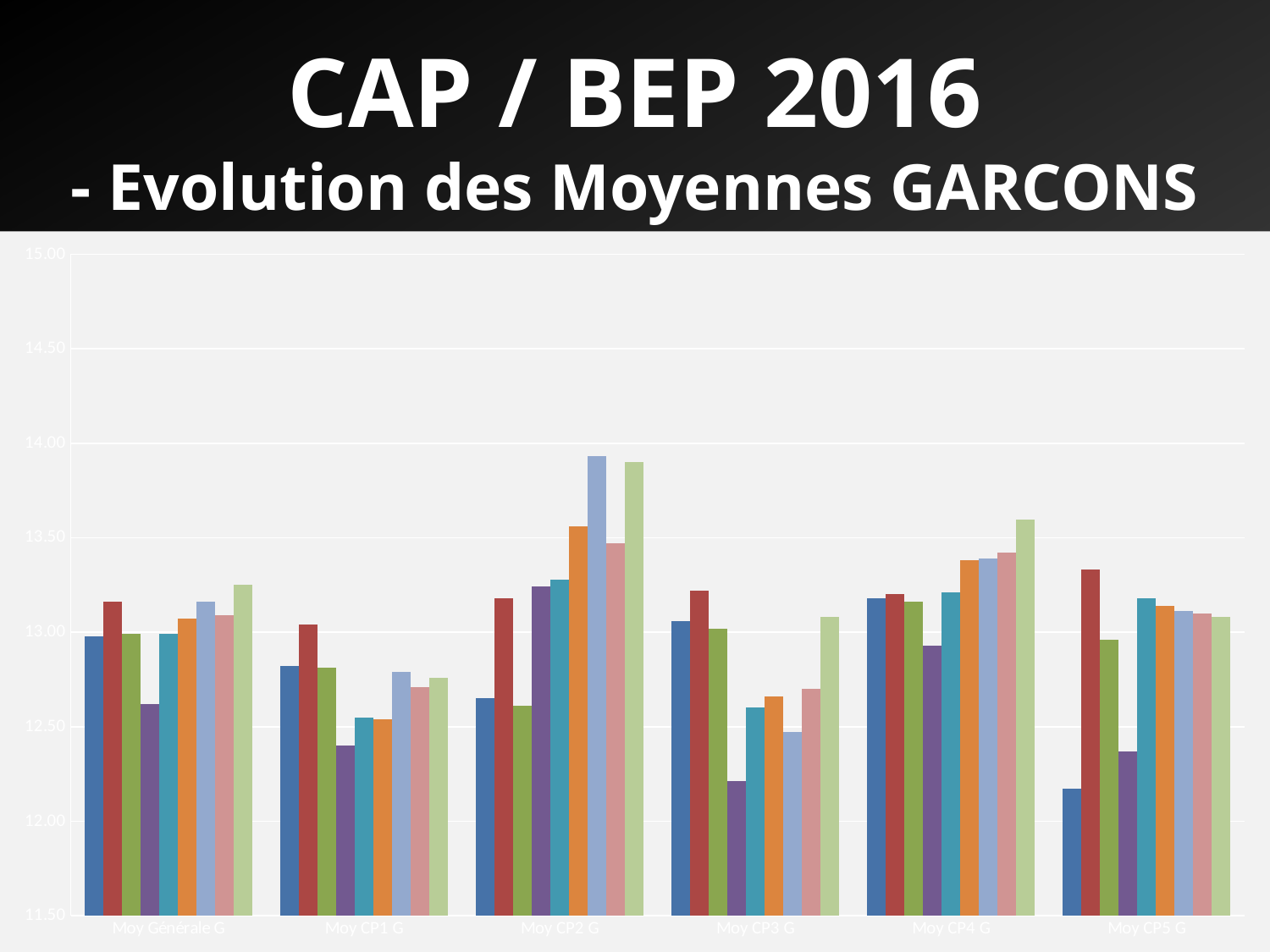
What kind of chart is shown on the slide? bar chart What is the lowest value shown on the chart's vertical axis? 11.50 How many categories are shown along the x axis of the chart? 6 In the Moy CP2 G group, which is taller: the first (blue) bar or the light blue bar? the light blue bar Is the value of the last (light green) bar for Moy CP4 G greater or less than 13.00? greater Which category contains the tallest bar in the chart? Moy CP2 G Is the value of the first (blue) bar for Moy CP5 G greater or less than 12.50? less Is the value of the tallest bar for Moy CP2 G greater or less than 13.50? greater How many bars are plotted in each category group of the chart? 9 In the Moy CP5 G group, which is taller: the blue bar or the red bar? the red bar What is the highest value shown on the chart's vertical axis? 15.00